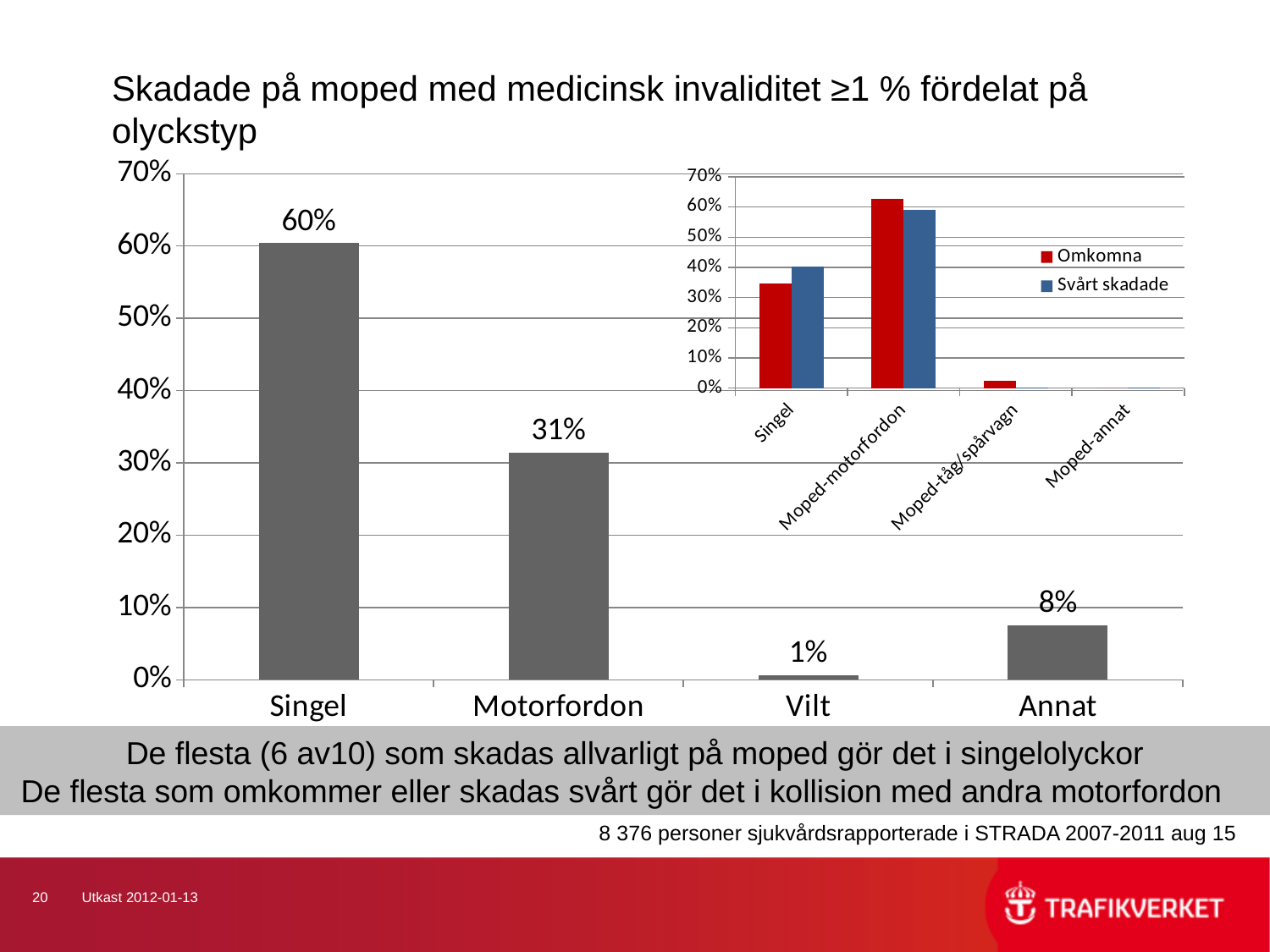
What type of chart is the small inset chart in the upper right? Bar chart In the large bar chart, which category has the highest value? Singel In the large bar chart, what is the difference between the values for Singel and Motorfordon? 29% In the large bar chart, what is the value for Singel? 60% In the small inset chart, is the Omkomna value for Moped-motorfordon greater or less than 50%? greater How many series does the legend of the small inset chart list? 2 How many categories are shown in the large bar chart? 4 In the large bar chart, which category has the lowest value? Vilt In the large bar chart, what is the value for Vilt? 1% In the small inset chart, which category has the highest Omkomna value? Moped-motorfordon In the large bar chart, what is the value for Motorfordon? 31% In the large bar chart, which is larger, the value for Annat or the value for Vilt? Annat